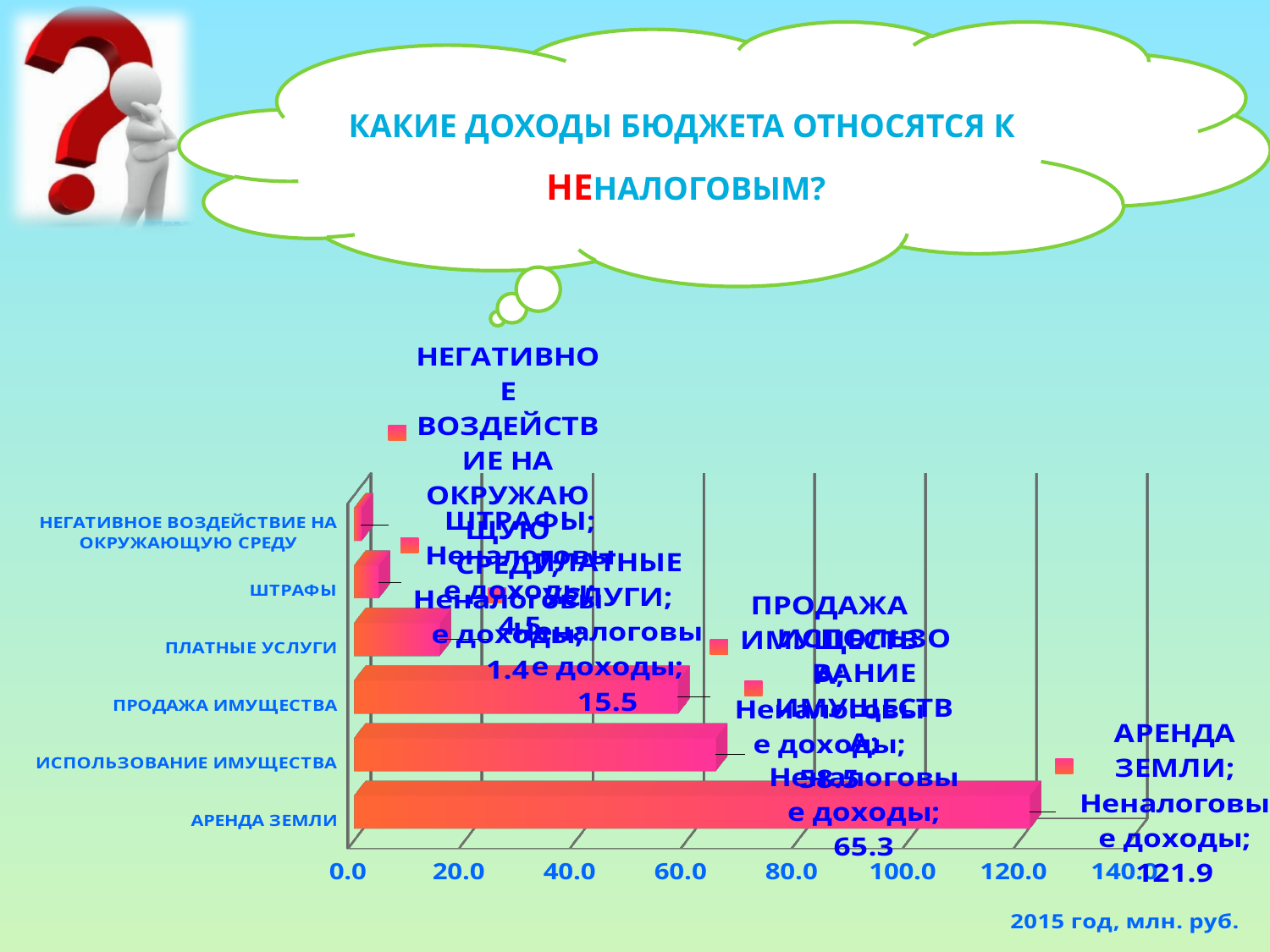
What year and units are stated below the chart? 2015 год, млн. руб. Which category has the highest value? АРЕНДА ЗЕМЛИ What is the difference between the values for АРЕНДА ЗЕМЛИ and ИСПОЛЬЗОВАНИЕ ИМУЩЕСТВА? 56.6 Which category has the lowest value? НЕГАТИВНОЕ ВОЗДЕЙСТВИЕ НА ОКРУЖАЮЩУЮ СРЕДУ Which is larger, the value for АРЕНДА ЗЕМЛИ or the value for ИСПОЛЬЗОВАНИЕ ИМУЩЕСТВА? АРЕНДА ЗЕМЛИ What is the value for ПЛАТНЫЕ УСЛУГИ? 15.5 What type of chart is shown on the slide? bar chart What is the value for АРЕНДА ЗЕМЛИ? 121.9 What is the value for ИСПОЛЬЗОВАНИЕ ИМУЩЕСТВА? 65.3 How many categories are plotted in the chart? 6 Is the value for ПРОДАЖА ИМУЩЕСТВА greater or less than 80.0? less Is the value for ШТРАФЫ greater or less than 20.0? less